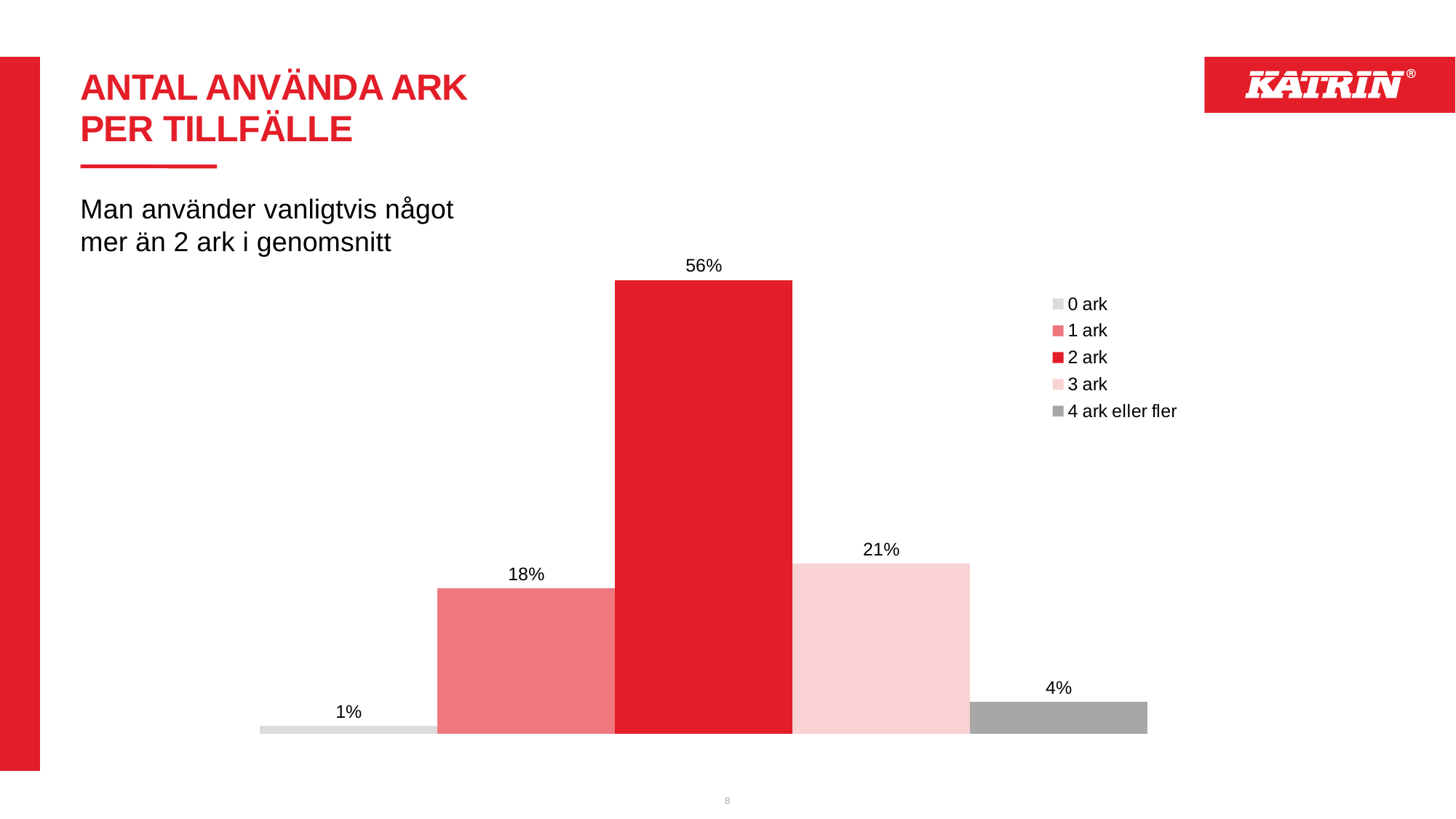
What percentage is shown for 4 ark eller fler? 4% What percentage is shown for 1 ark? 18% What kind of chart is shown on the slide? Bar chart Which category has the highest value? 2 ark Which is larger, the value for 1 ark or the value for 4 ark eller fler? 1 ark What is the difference between the values for 2 ark and 3 ark? 35% How many categories does the legend list? 5 What percentage is shown for 2 ark? 56% What percentage is shown for 3 ark? 21% What is the difference between the values for 3 ark and 1 ark? 3% What is the title of the slide containing the chart? ANTAL ANVÄNDA ARK PER TILLFÄLLE Which category has the lowest value? 0 ark